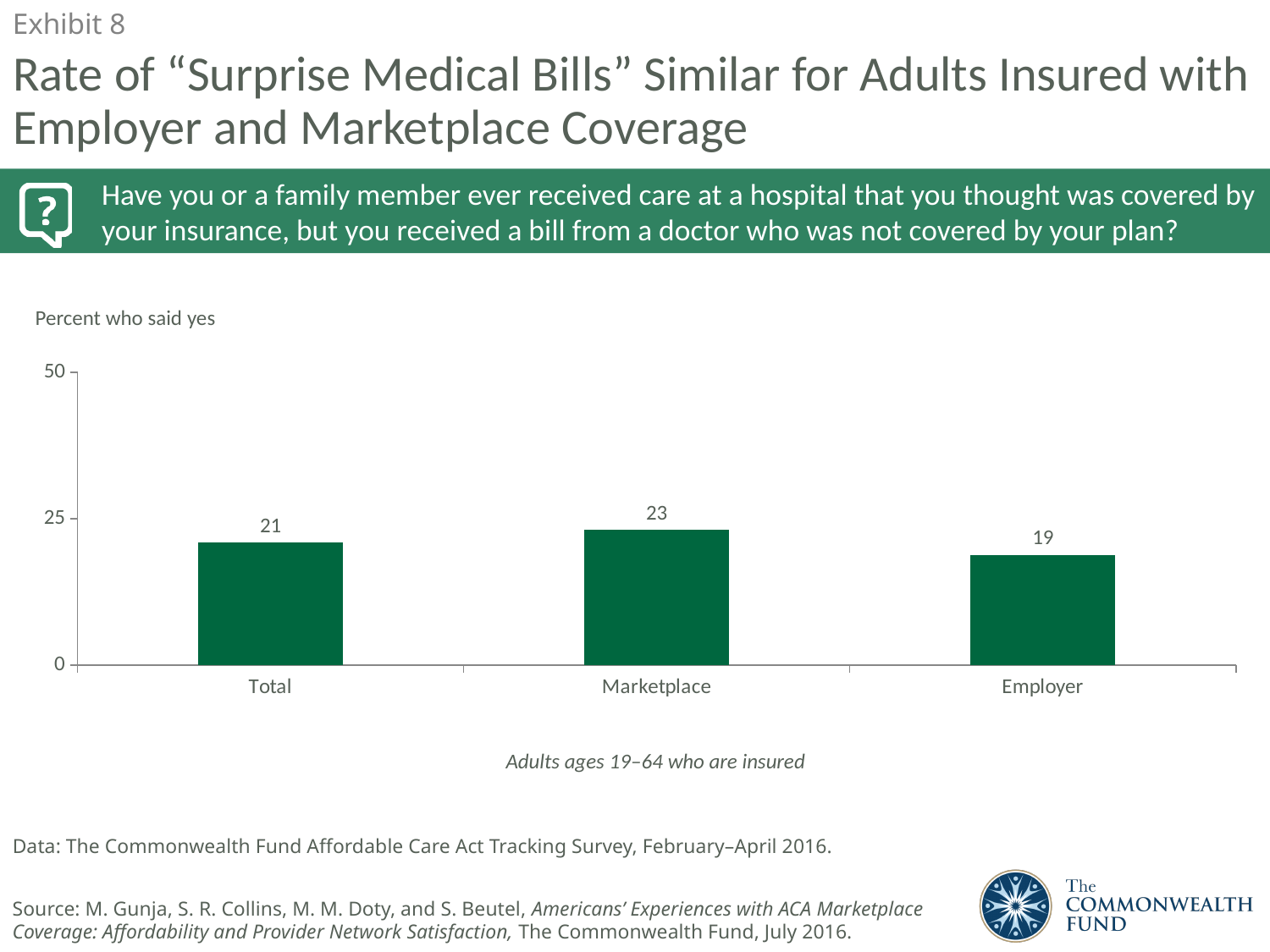
What is the value for Marketplace? 23 Is the value for Marketplace greater or less than 25? less What kind of chart is shown on the slide? bar chart What is the value for Total? 21 Which category has the highest value? Marketplace Which is larger, the value for Marketplace or the value for Total? Marketplace What is the difference between the values for Total and Employer? 2 What is the value for Employer? 19 How many categories are shown on the x axis? 3 What is the label above the chart describing what the values represent? Percent who said yes Which category has the lowest value? Employer What is the difference between the values for Marketplace and Employer? 4